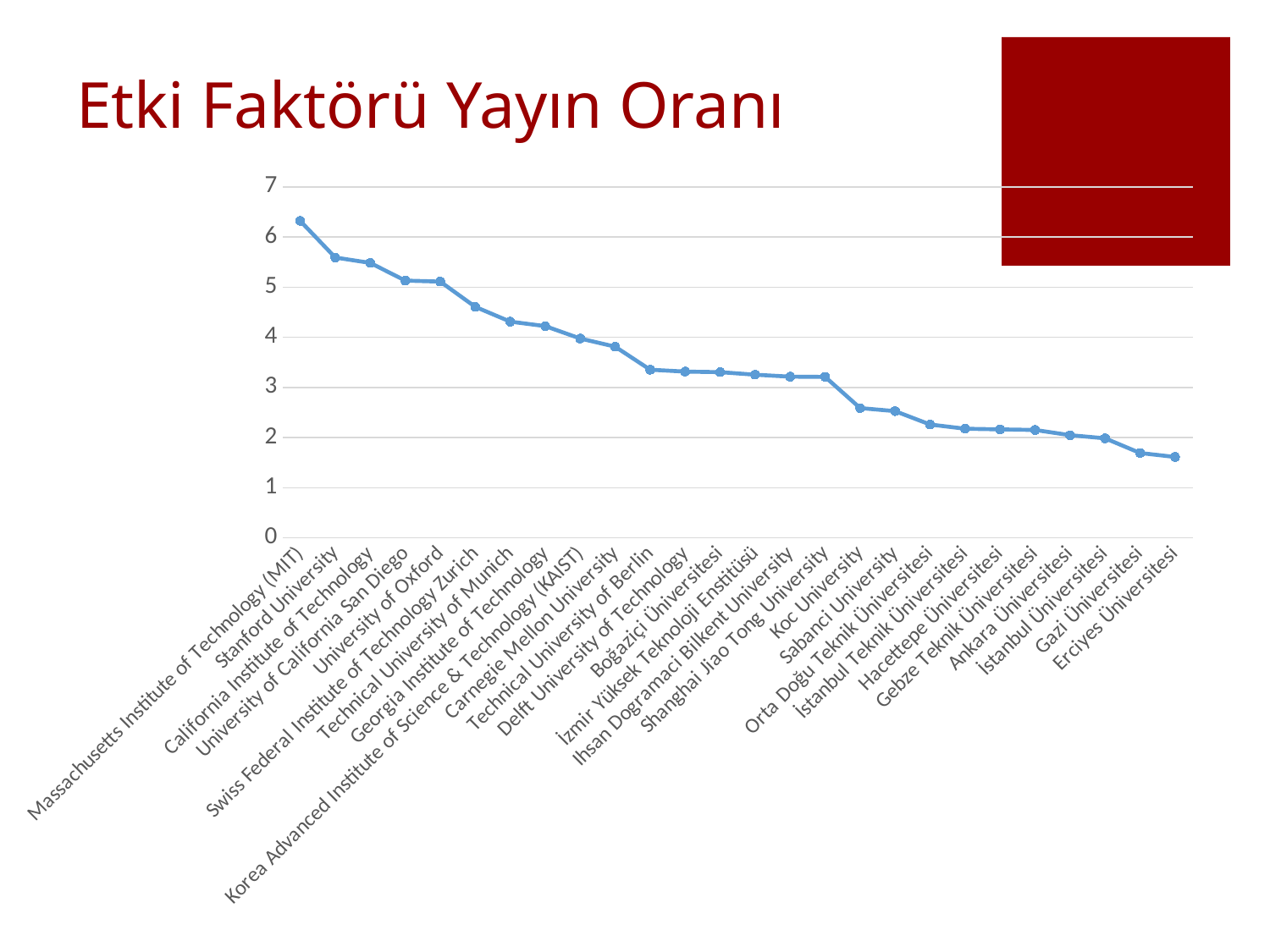
Is the value for Koc University greater or less than 3? less Do the values rise or fall moving from left to right along the x axis? fall Which has the larger value, University of Oxford or Ankara Üniversitesi? University of Oxford Is the value for Swiss Federal Institute of Technology Zurich greater or less than 4? greater Is the value for Erciyes Üniversitesi greater or less than 2? less How many universities are plotted on the x axis? 26 Which university has the lowest value? Erciyes Üniversitesi What is the title of the chart? Etki Faktörü Yayın Oranı What kind of chart is shown on the slide? line chart Which university has the highest value? Massachusetts Institute of Technology (MIT)